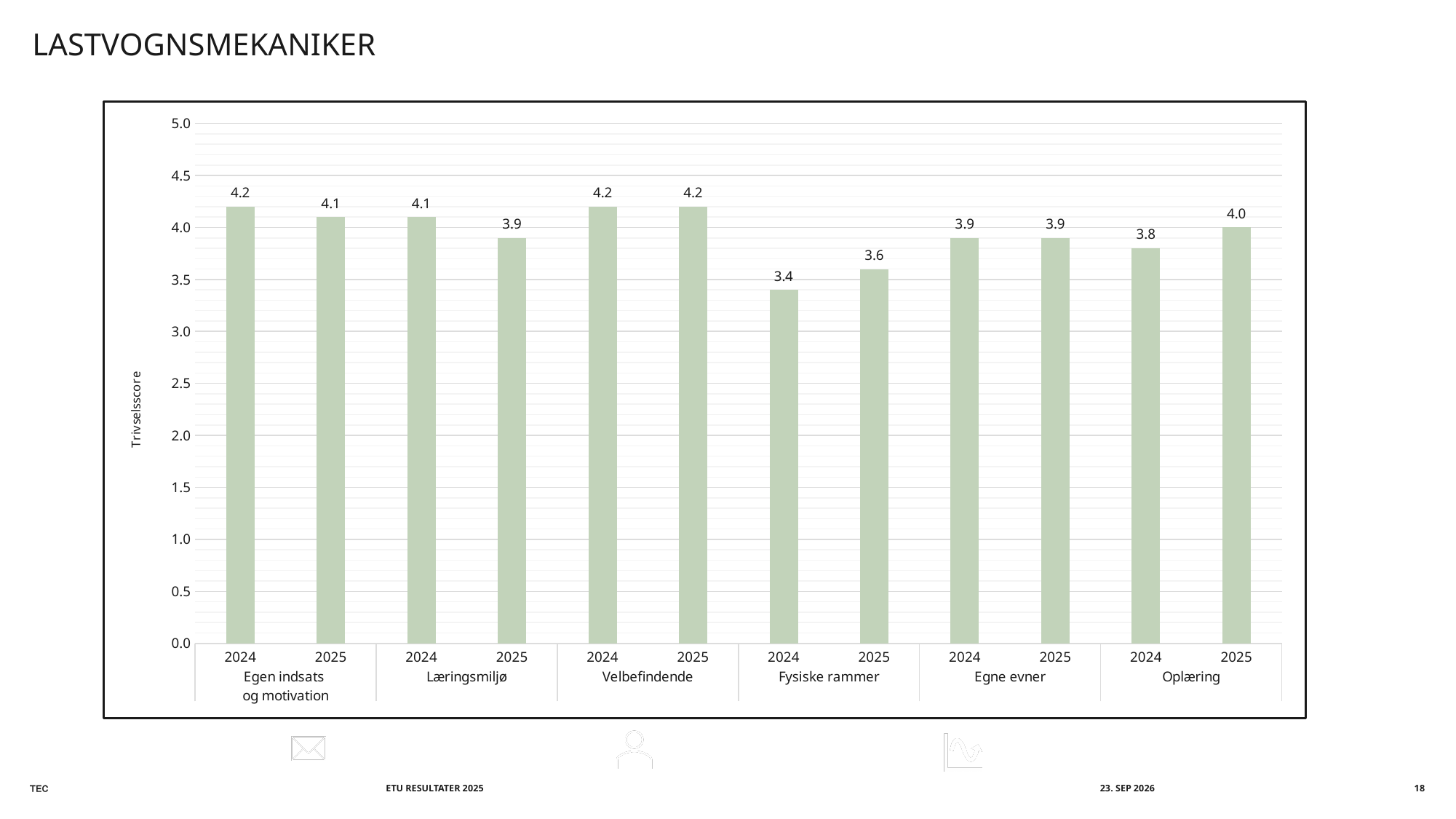
What is the Trivselsscore for Fysiske rammer in 2024? 3.4 Is the 2025 Trivselsscore for Fysiske rammer greater or less than 4.0? less What is the label of the y axis? Trivselsscore Which is larger, the 2024 or the 2025 Trivselsscore for Oplæring? 2025 What is the difference between the 2024 and 2025 Trivselsscore for Fysiske rammer? 0.2 What is the Trivselsscore for Oplæring in 2025? 4.0 How many categories are shown on the x axis? 6 Which category and year has the lowest Trivselsscore? Fysiske rammer 2024 What is the Trivselsscore for Egen indsats og motivation in 2024? 4.2 What is the difference between the 2024 and 2025 Trivselsscore for Læringsmiljø? 0.2 What kind of chart is shown on the slide? bar chart What is the Trivselsscore for Læringsmiljø in 2025? 3.9